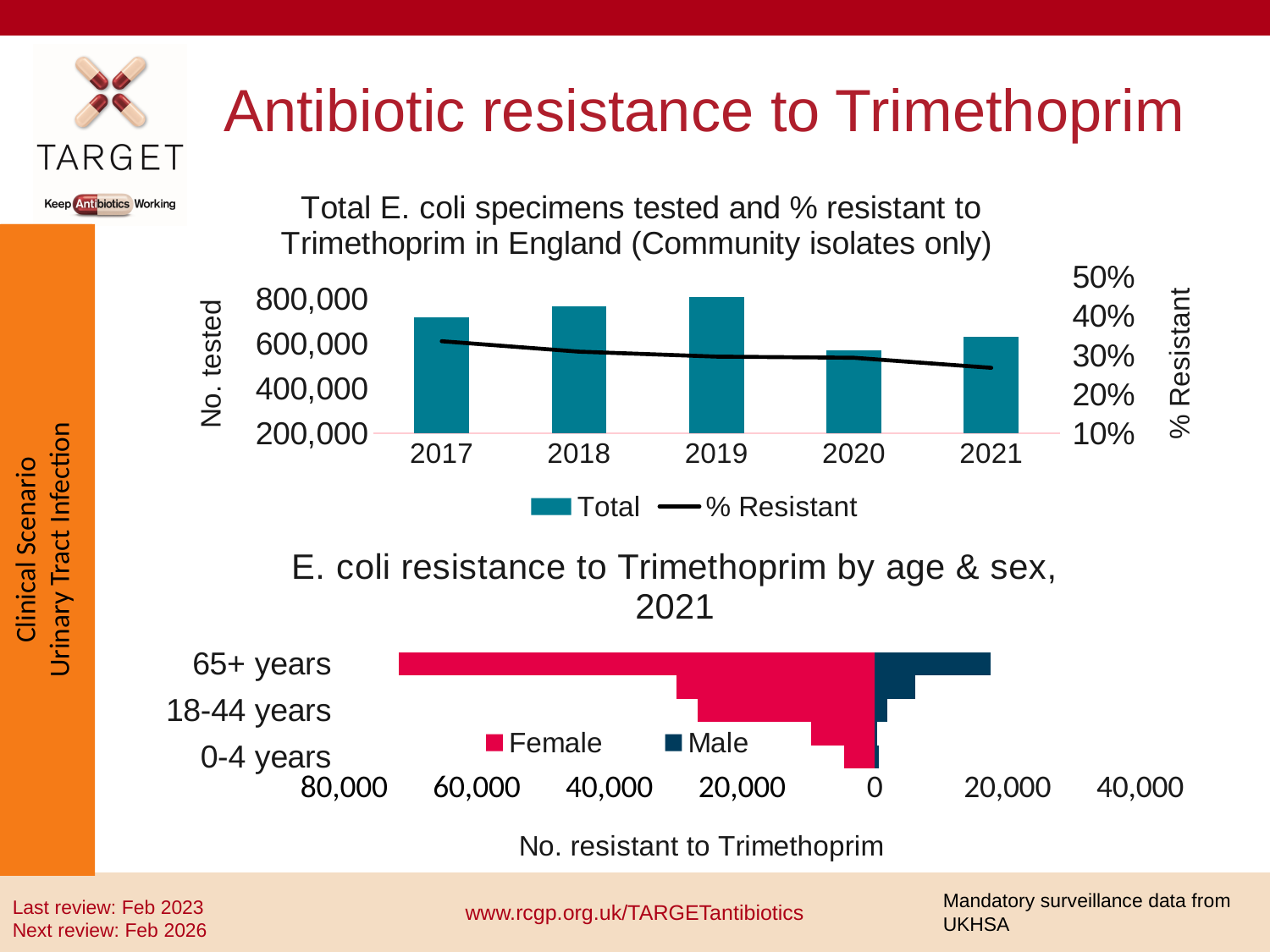
In the top chart, which year has the lowest Total number tested? 2020 What kind of chart is the bottom chart, 'E. coli resistance to Trimethoprim by age & sex, 2021'? A bar chart In the top chart, is the % Resistant value for 2021 greater or less than 30%? less What kind of chart is the top chart, 'Total E. coli specimens tested and % resistant to Trimethoprim in England'? A bar chart with a line In the top chart, which year has the larger Total, 2018 or 2021? 2018 In the top chart, how many series does the legend list? 2 In the bottom chart, is the Female value for 65+ years greater or less than 60,000? greater In the top chart, does the % Resistant line rise or fall from 2017 to 2021? Fall In the bottom chart, which series has the larger value for 65+ years, Female or Male? Female In the top chart, is the Total for 2017 greater or less than 600,000? greater In the top chart, which year has the highest Total number tested? 2019 In the top chart, how many years are shown on the x axis? 5